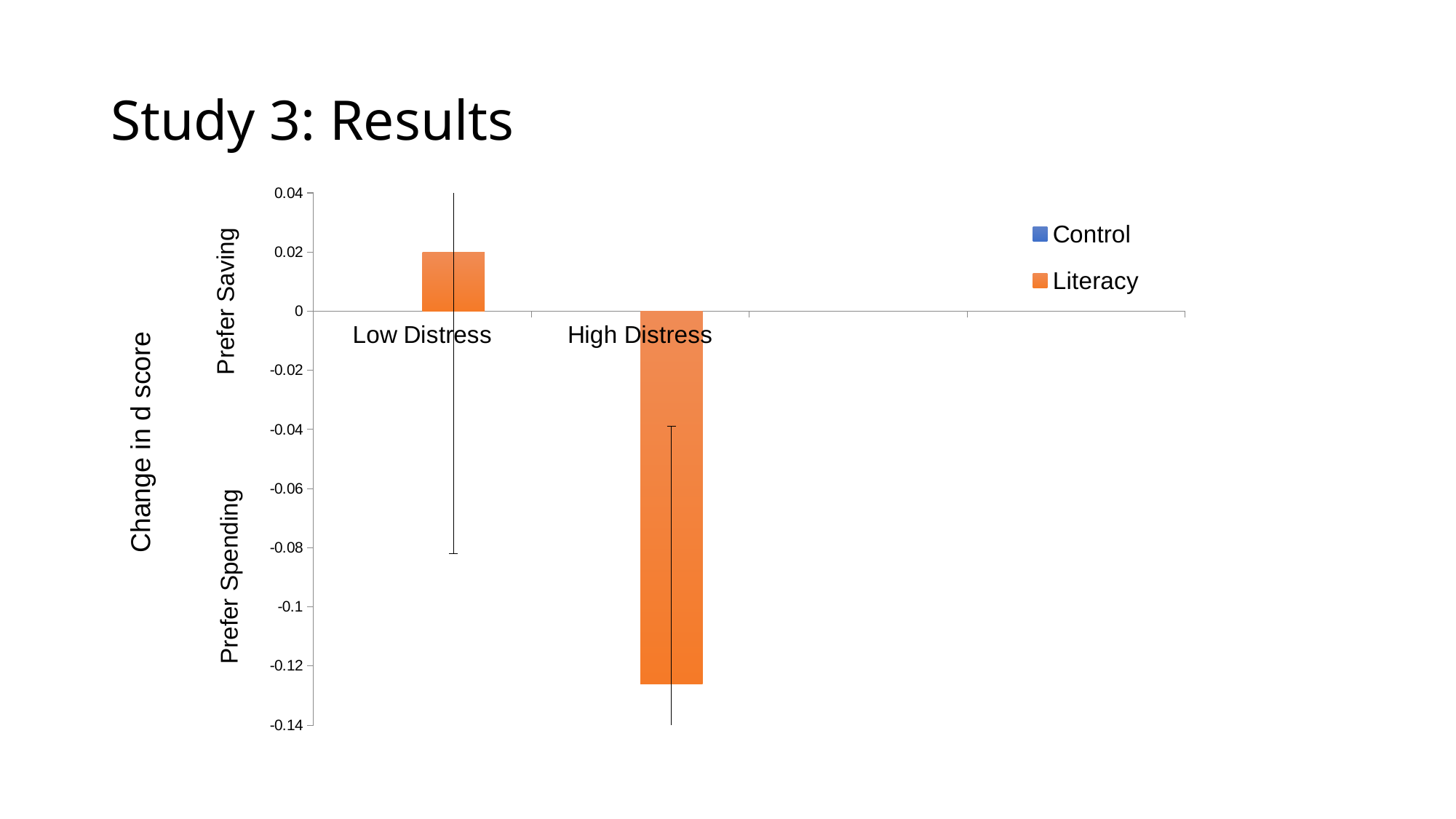
How many categories are shown on the x axis? 2 What colour represents the Literacy series in the legend? orange Which category has the higher Literacy value, Low Distress or High Distress? Low Distress What is the Literacy value for Low Distress? 0.02 How many series does the legend list? 2 What is the label on the y axis? Change in d score Which category has the highest Literacy value? Low Distress Is the Literacy value for High Distress greater or less than -0.14? greater What kind of chart is shown on the slide? bar chart Which category has the lowest Literacy value? High Distress Do the Literacy values rise or fall from Low Distress to High Distress? fall Is the Literacy value for High Distress greater or less than -0.1? less